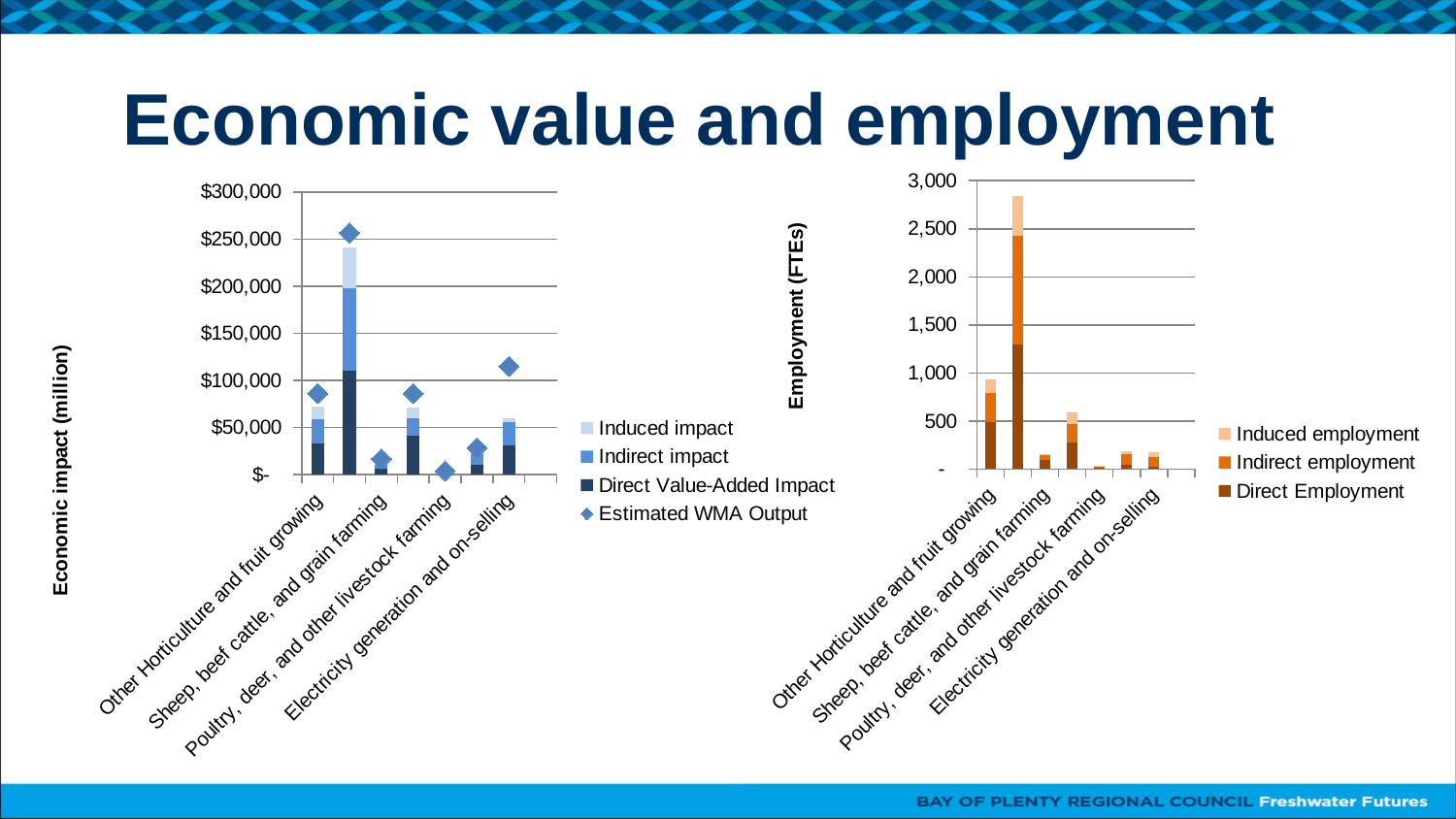
What is the vertical axis title of the right chart? Employment (FTEs) How many series does the legend of the left chart (Economic impact) list? 4 In the left chart (Economic impact), is the Estimated WMA Output for Other Horticulture and fruit growing greater or less than $100,000? less In the left chart (Economic impact), which has the higher Estimated WMA Output: Electricity generation and on-selling or Other Horticulture and fruit growing? Electricity generation and on-selling In the right chart (Employment), which has higher total employment: Other Horticulture and fruit growing or Sheep, beef cattle, and grain farming? Other Horticulture and fruit growing What kind of chart is the left chart (Economic impact)? Bar chart What kind of chart is the right chart (Employment)? Bar chart In the left chart (Economic impact), is the Estimated WMA Output for Electricity generation and on-selling greater or less than $100,000? greater How many series does the legend of the right chart (Employment) list? 3 In the right chart (Employment), is the total employment for Other Horticulture and fruit growing greater or less than 1,000? less